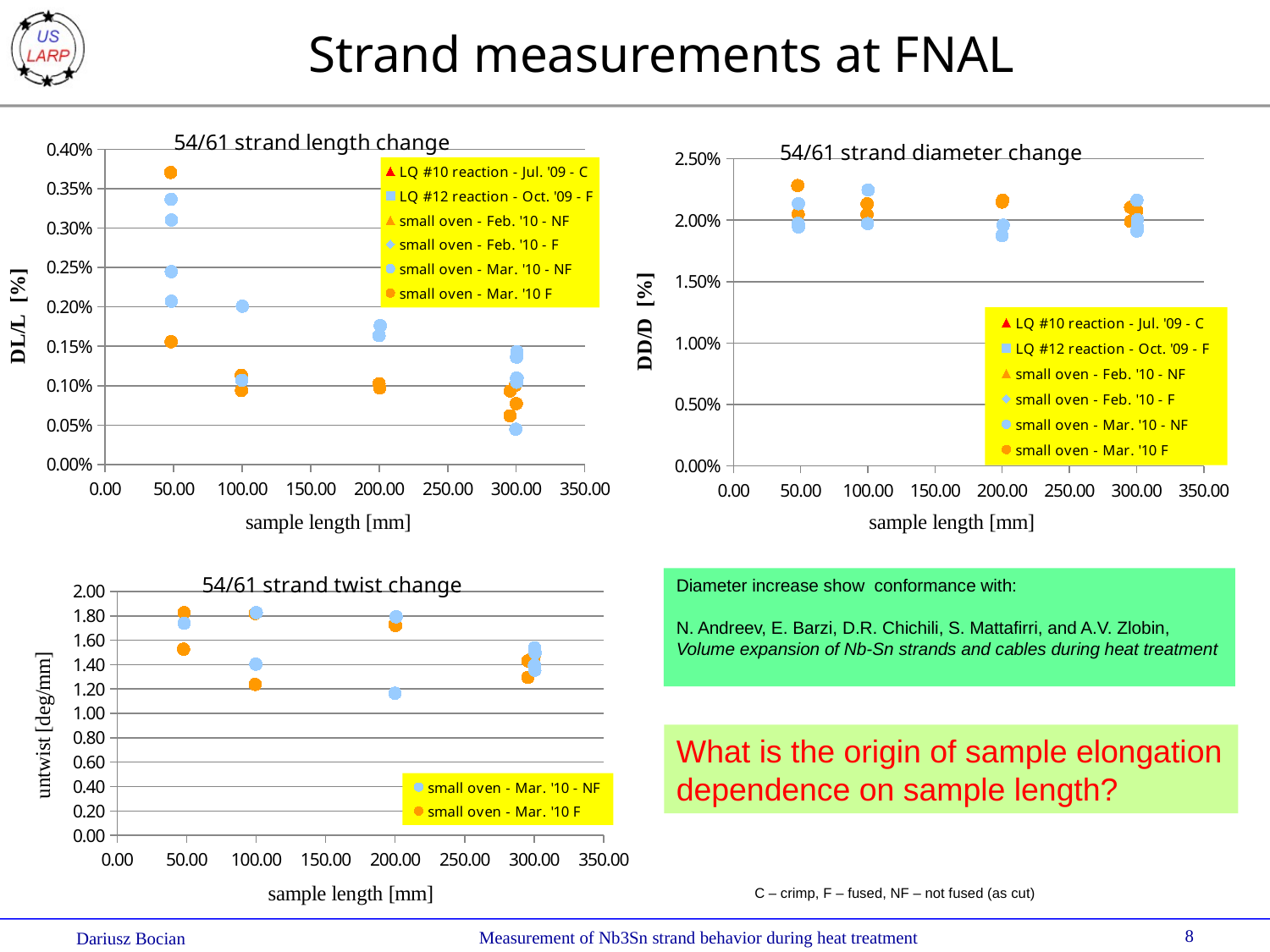
At how many distinct sample lengths are points plotted in the '54/61 strand twist change' chart? 4 How many series does the legend of the '54/61 strand diameter change' chart list? 6 In the '54/61 strand diameter change' chart, are the values at a sample length of 50 mm greater or less than 1.50%? greater What is the x-axis label of the '54/61 strand diameter change' chart? sample length [mm] How many series does the legend of the '54/61 strand twist change' chart list? 2 In the '54/61 strand length change' chart, are the values at a sample length of 300 mm greater or less than 0.20%? less In the '54/61 strand length change' chart, are the highest values at a sample length of 50 mm greater or less than 0.30%? greater In the '54/61 strand length change' chart, do the DL/L values generally rise or fall as sample length increases? fall What is the y-axis label of the '54/61 strand twist change' chart? untwist [deg/mm] How many series does the legend of the '54/61 strand length change' chart list? 6 What kind of chart is the '54/61 strand length change' chart? scatter chart